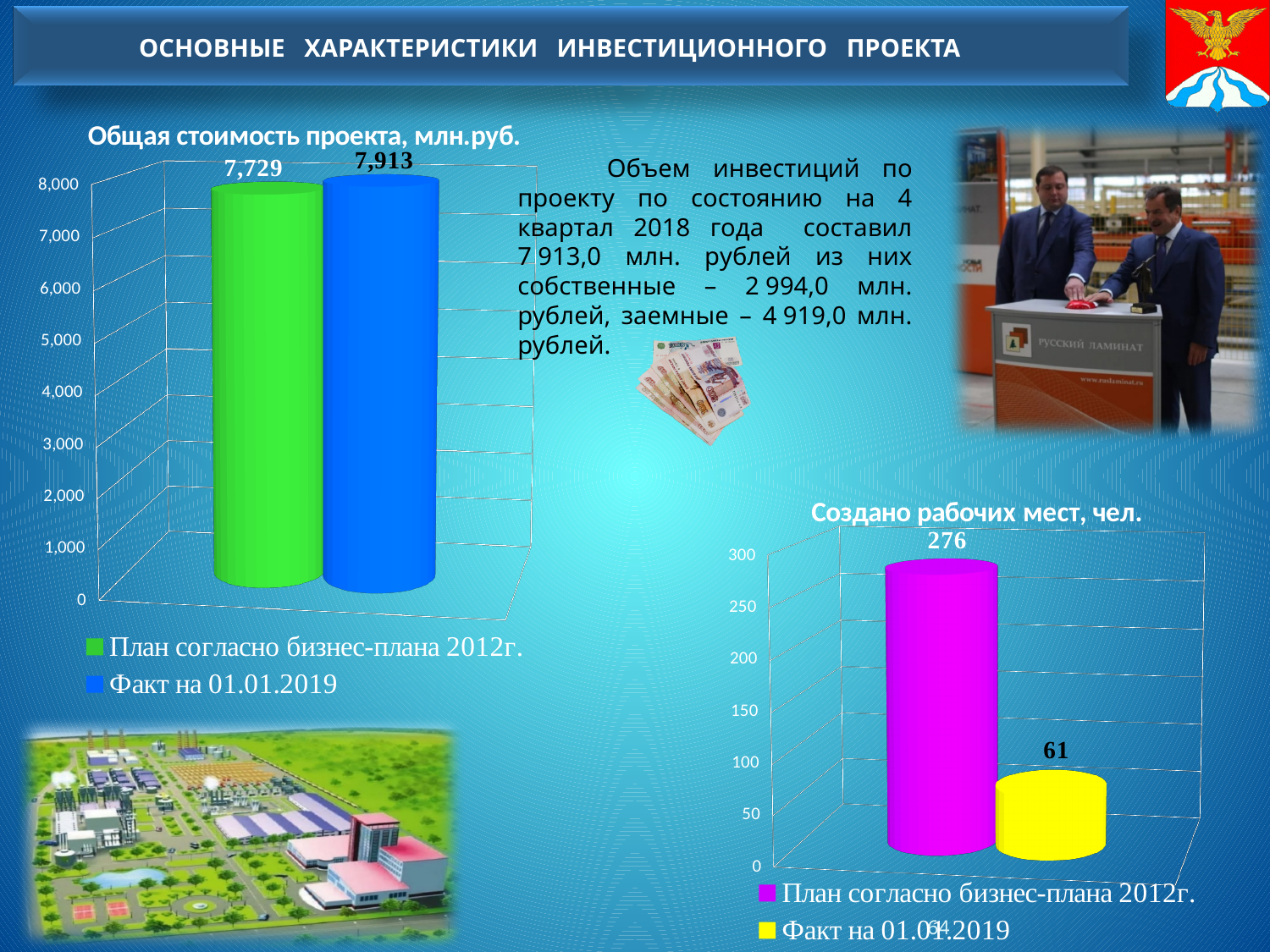
In the chart titled "Общая стоимость проекта, млн.руб.", what is the value for "Факт на 01.01.2019"? 7,913 In the chart titled "Общая стоимость проекта, млн.руб.", what is the value for "План согласно бизнес-плана 2012г."? 7,729 In the chart titled "Общая стоимость проекта, млн.руб.", which series has the higher value? Факт на 01.01.2019 In the chart titled "Создано рабочих мест, чел.", which series has the lowest value? Факт на 01.01.2019 In the chart titled "Создано рабочих мест, чел.", is the value for "Факт на 01.01.2019" greater or less than 100? less In the chart titled "Общая стоимость проекта, млн.руб.", what is the difference between the "Факт на 01.01.2019" value and the "План согласно бизнес-плана 2012г." value? 184 In the chart titled "Создано рабочих мест, чел.", what is the difference between the "План согласно бизнес-плана 2012г." value and the "Факт на 01.01.2019" value? 215 In the chart titled "Создано рабочих мест, чел.", what is the value for "Факт на 01.01.2019"? 61 In the chart titled "Общая стоимость проекта, млн.руб.", how many series does the legend list? 2 In the chart titled "Создано рабочих мест, чел.", what is the value for "План согласно бизнес-плана 2012г."? 276 In the chart titled "Создано рабочих мест, чел.", what colour is the bar for "Факт на 01.01.2019"? Yellow What kind of chart is the chart titled "Создано рабочих мест, чел."? Bar chart